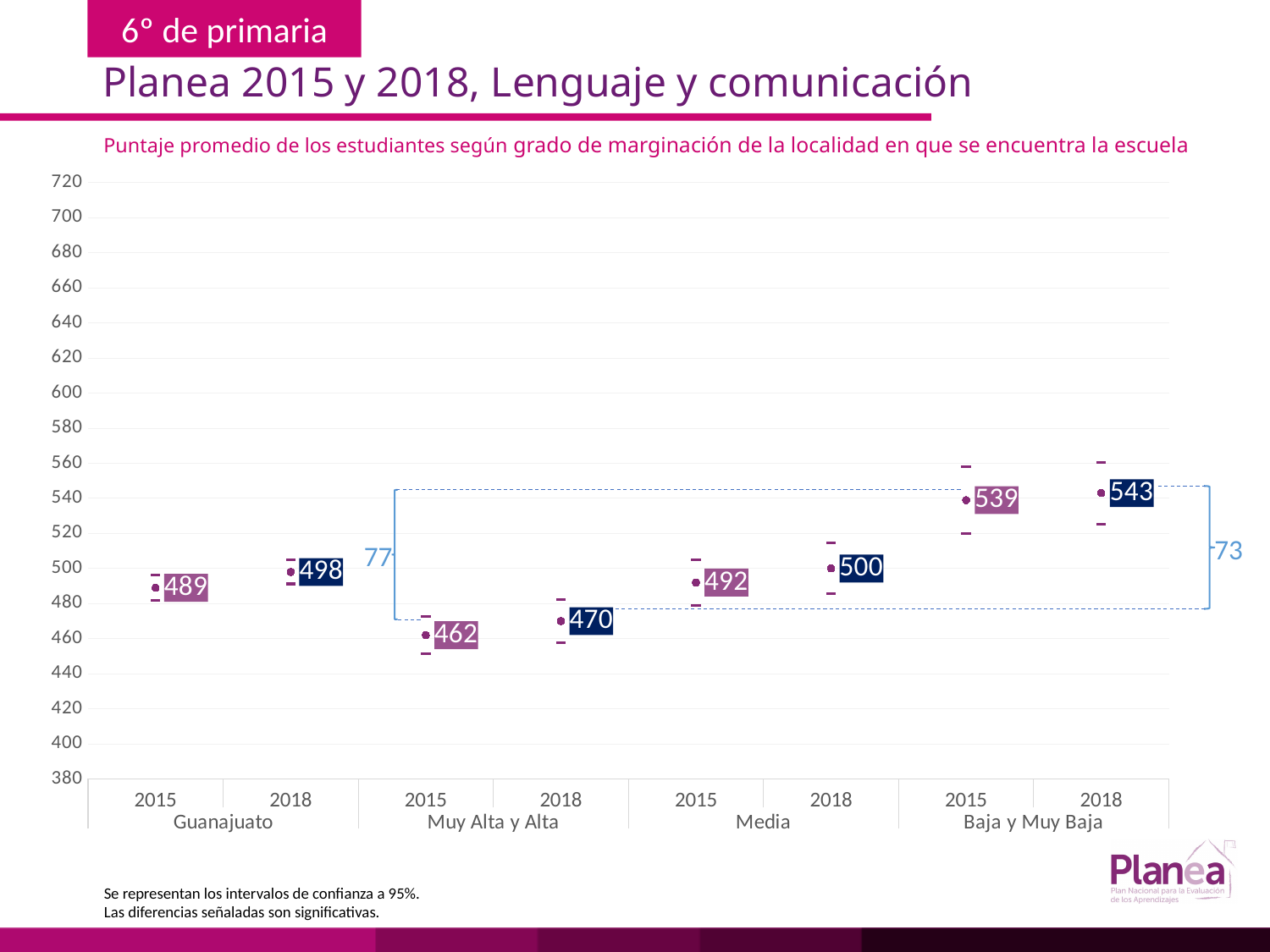
Which group and year has the lowest average score? Muy Alta y Alta, 2015 (462) What is the average score for Muy Alta y Alta in 2018? 470 Is the 2015 score for Baja y Muy Baja greater or less than 520? greater What is the average score for Guanajuato in 2015? 489 What is the difference between the Baja y Muy Baja and Muy Alta y Alta scores in 2015? 77 What is the average score for Baja y Muy Baja in 2015? 539 From 2015 to 2018, do the scores rise or fall within each marginalization group? rise Which is larger, the 2018 score for Media or the 2018 score for Guanajuato? Media (500) What is the difference between the 2018 and 2015 scores for Guanajuato? 9 How many data points are plotted on the chart? 8 What is the average score for Media in 2018? 500 Which group and year has the highest average score? Baja y Muy Baja, 2018 (543)